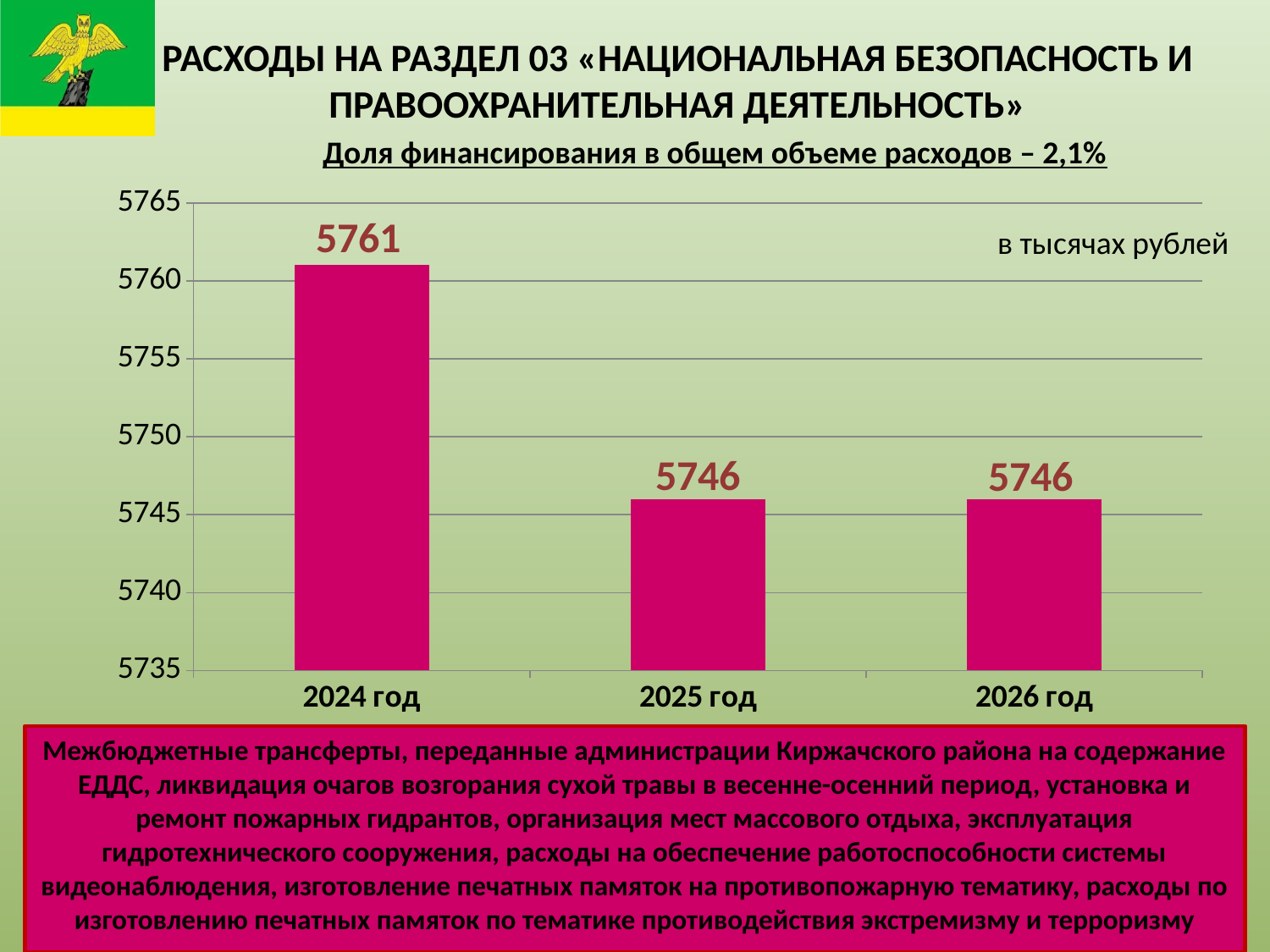
Is the value for 2024 год greater or less than 5755? greater Which is larger, the value for 2024 год or the value for 2026 год? 2024 год In what units are the chart values given, according to the note on the chart? в тысячах рублей What is the value for 2026 год? 5746 How many years are shown on the chart? 3 Do the values rise or fall from 2024 год to 2025 год? fall Is the value for 2025 год greater or less than 5750? less What is the value for 2025 год? 5746 Which year has the highest value? 2024 год What kind of chart is shown on the slide? bar chart What is the value for 2024 год? 5761 What is the difference between the values for 2024 год and 2025 год? 15